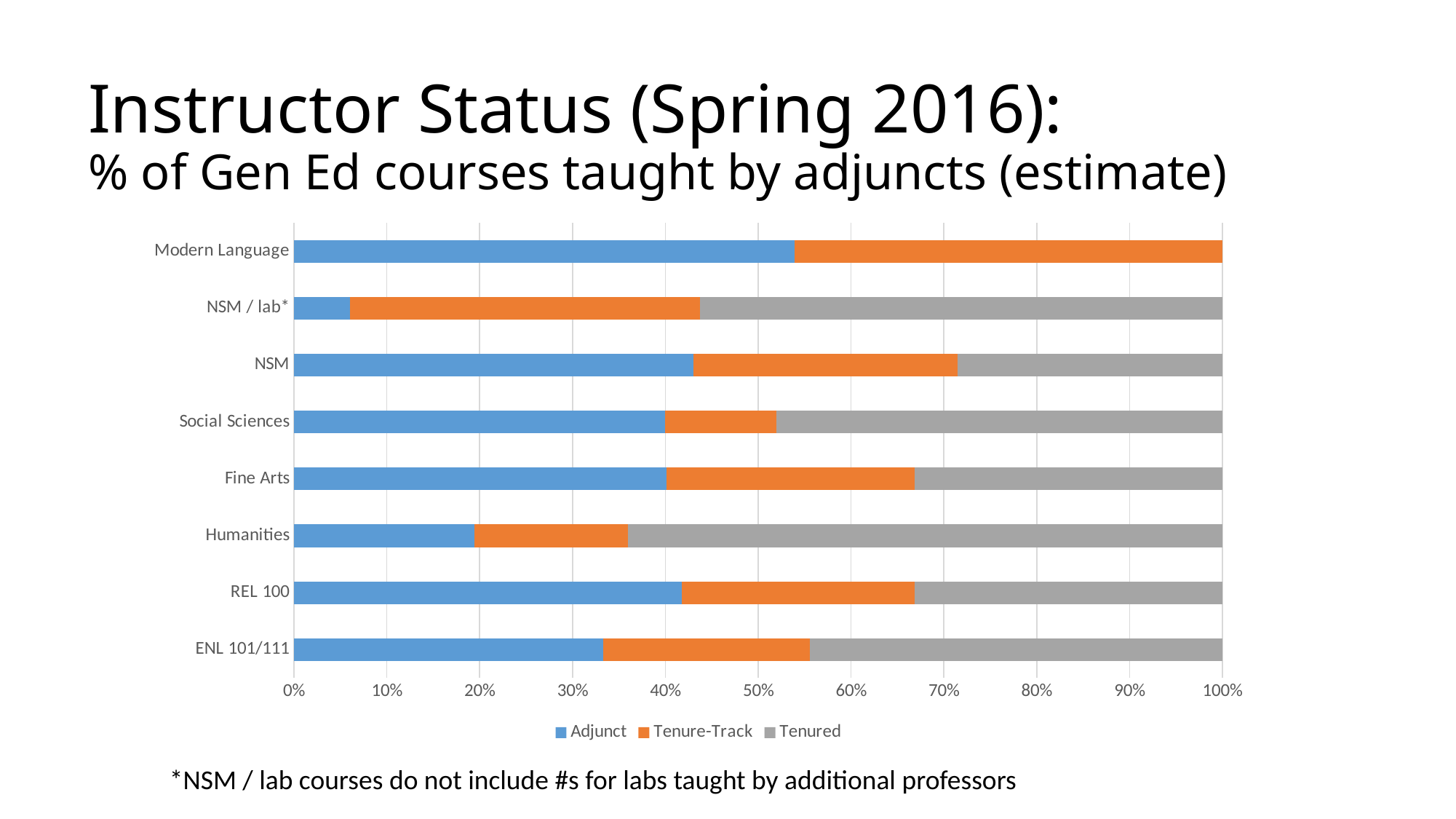
How many categories (rows) are plotted on the chart? 8 Which category has the smallest Adjunct share? NSM / lab* Which series is shown in orange in the legend? Tenure-Track Which category has the largest Adjunct share? Modern Language How many series does the legend list? 3 What kind of chart is shown on the slide? Stacked bar chart Which category has no Tenured segment in its bar? Modern Language Is the Adjunct share for Humanities greater or less than 30%? less Which has a larger Adjunct share, Humanities or ENL 101/111? ENL 101/111 Is the Adjunct share for Modern Language greater or less than 50%? greater Which category has the largest Tenure-Track share? Modern Language Is the Adjunct share for NSM / lab* greater or less than 10%? less